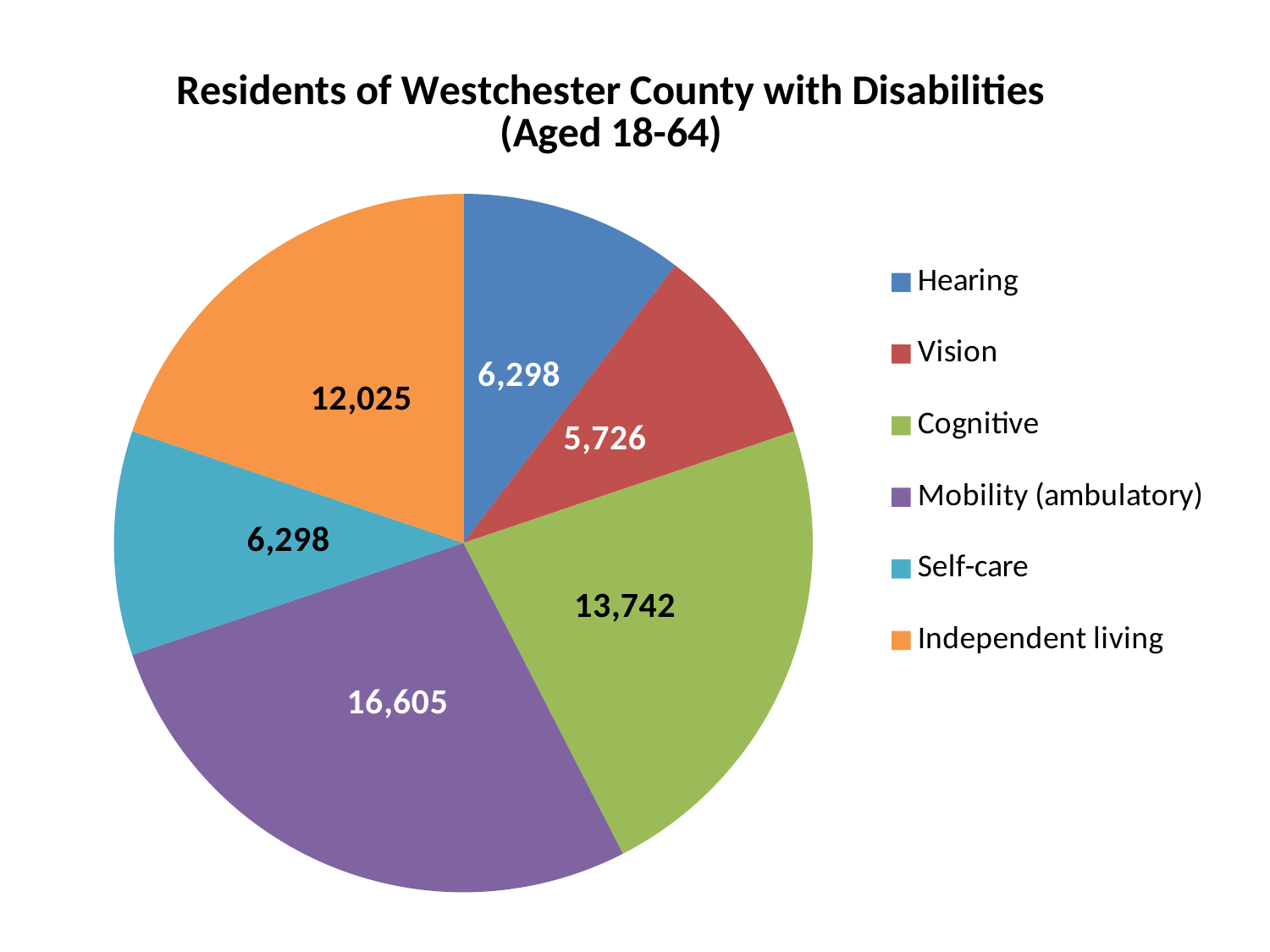
What is the total of all the slices in the pie chart? 60,694 What is the value for Mobility (ambulatory)? 16,605 What is the value for Vision? 5,726 What is the value for Cognitive? 13,742 What is the title of the chart? Residents of Westchester County with Disabilities (Aged 18-64) Which category has the largest slice of the pie? Mobility (ambulatory) Which category has the smallest slice of the pie? Vision What is the value for Independent living? 12,025 What type of chart is shown on the slide? Pie chart Which is larger, the value for Cognitive or the value for Independent living? Cognitive How many categories does the pie chart show? 6 What is the difference between the values for Mobility (ambulatory) and Cognitive? 2,863